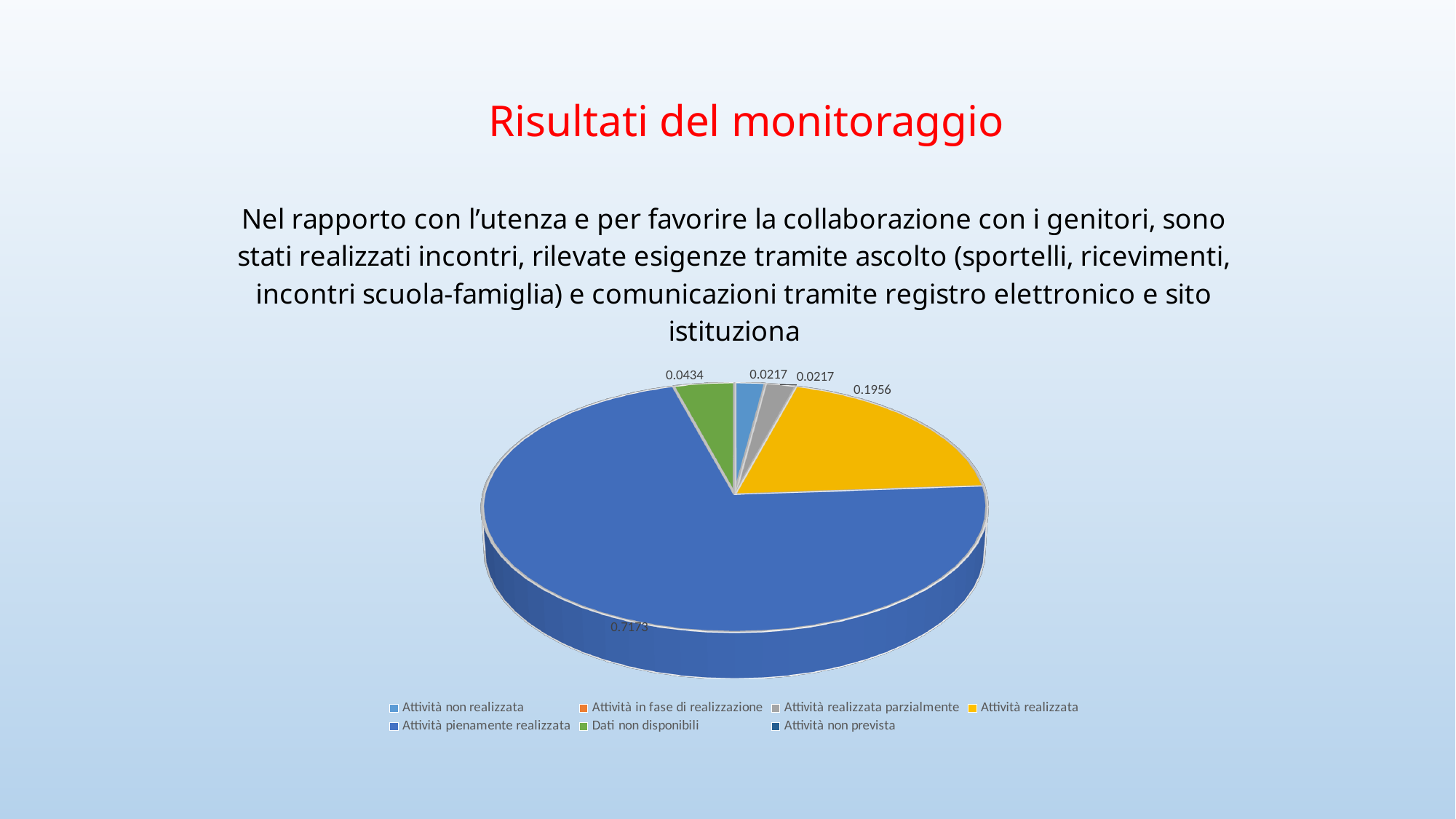
Which is larger, the value for Dati non disponibili or the value for Attività non realizzata? Dati non disponibili What is the difference between the values for Attività pienamente realizzata and Attività realizzata? 0.5217 How many slices with data labels are visible in the pie? 5 What kind of chart is shown on the slide? pie chart What is the value for Attività non realizzata? 0.0217 What is the difference between the values for Attività realizzata and Dati non disponibili? 0.1522 What is the value for Dati non disponibili? 0.0434 What is the value for Attività realizzata parzialmente? 0.0217 How many entries does the legend list? 7 Which category has the largest slice of the pie? Attività pienamente realizzata What is the value for Attività pienamente realizzata? 0.7173 What is the value for Attività realizzata? 0.1956